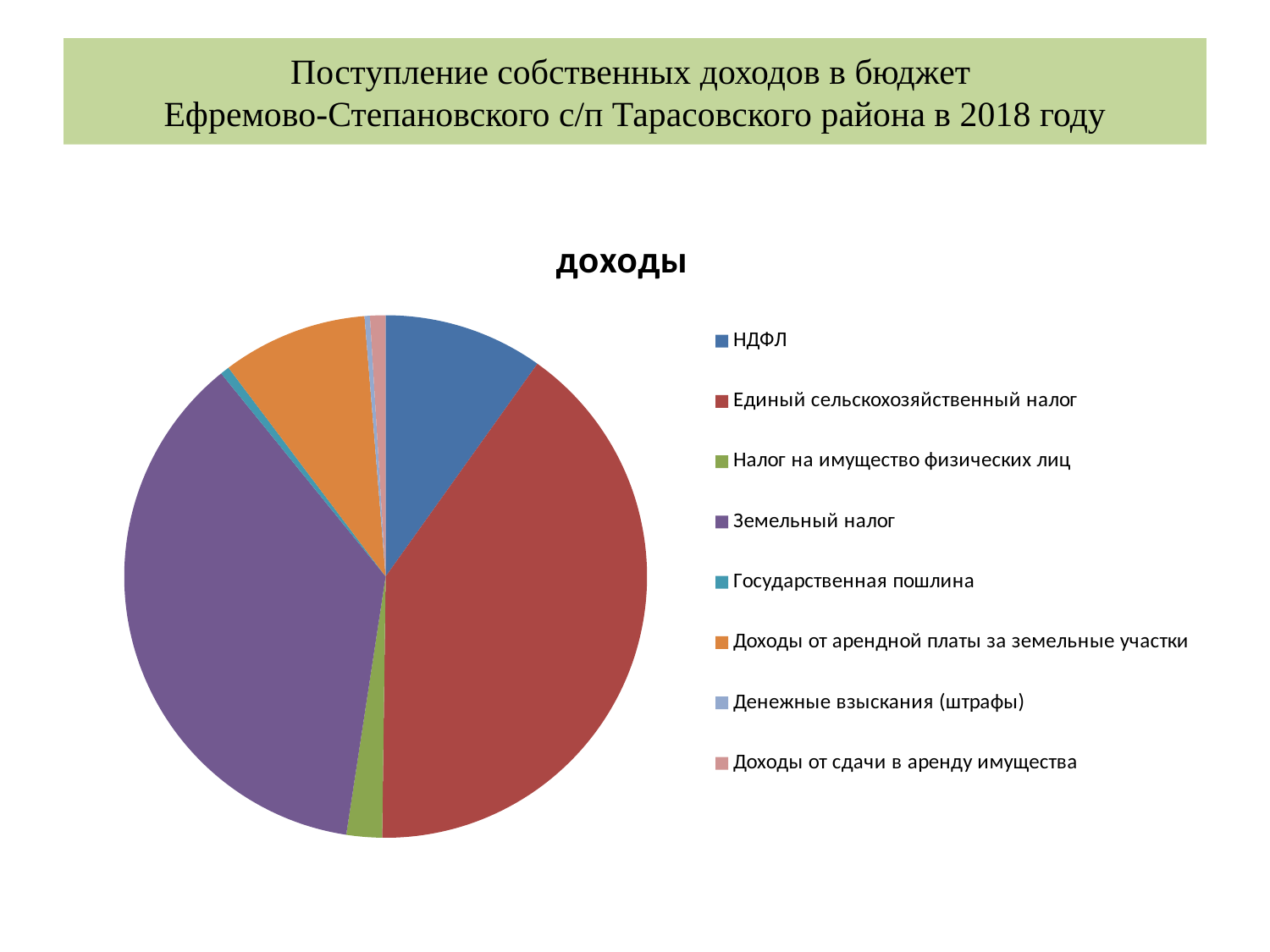
How many entries does the legend of the pie chart list? 8 Which category has the largest slice in the pie chart? Единый сельскохозяйственный налог How many slices does the pie chart have? 8 What colour represents Земельный налог in the pie chart? purple Which slice is larger: Единый сельскохозяйственный налог or Земельный налог? Единый сельскохозяйственный налог What is the title of the pie chart? доходы What kind of chart is shown on the slide? pie chart Which slice is larger: Земельный налог or НДФЛ? Земельный налог Which slice is larger: Доходы от арендной платы за земельные участки or Налог на имущество физических лиц? Доходы от арендной платы за земельные участки